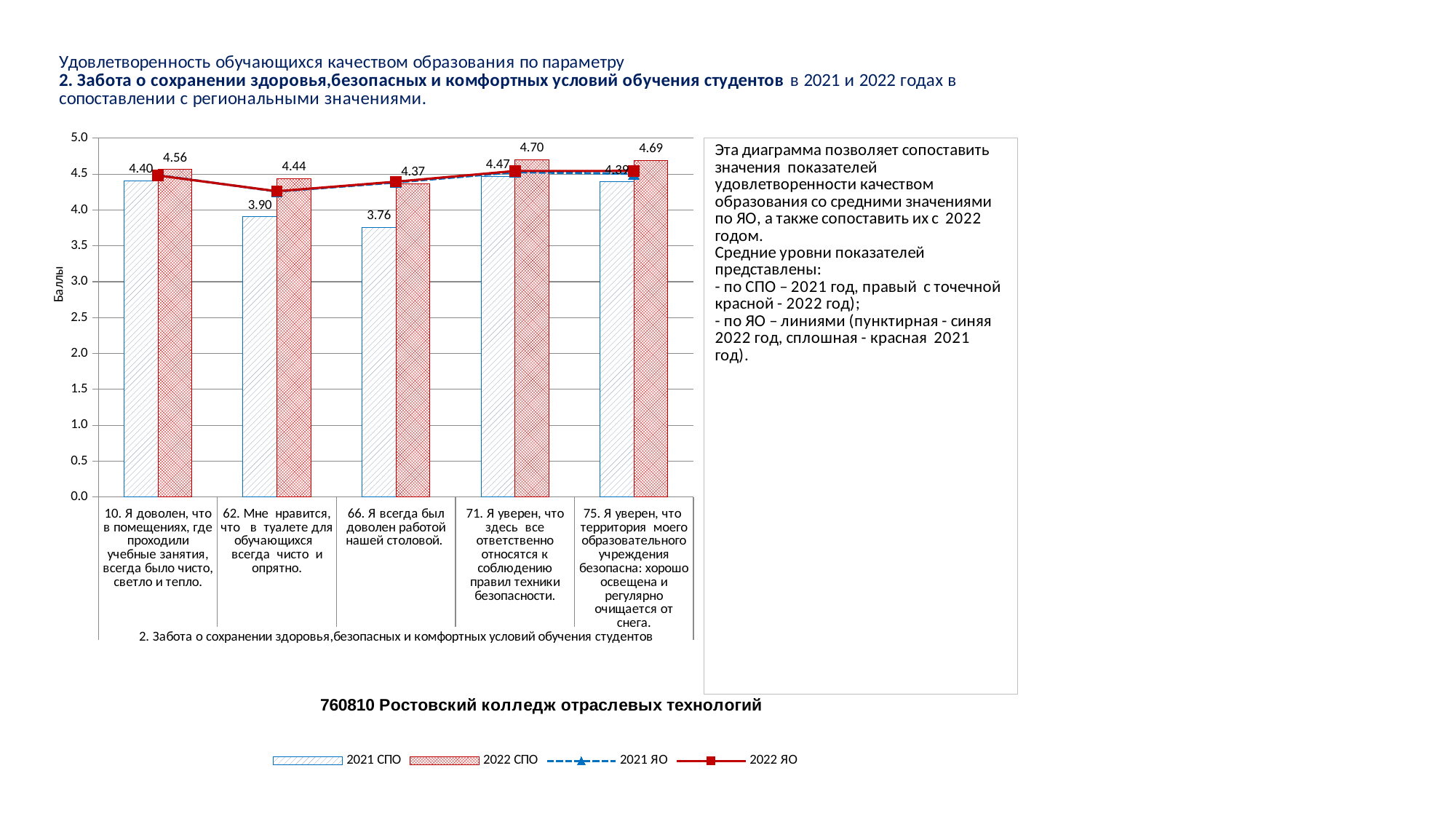
How many survey items (categories) are shown on the x axis? 5 What is the 2022 СПО value for item 62 (Мне нравится, что в туалете для обучающихся всегда чисто и опрятно)? 4.44 What is the difference between the 2022 СПО and 2021 СПО values for item 10? 0.16 What is the 2022 СПО value for item 10 (Я доволен, что в помещениях, где проходили учебные занятия, всегда было чисто, светло и тепло)? 4.56 How many series does the legend list? 4 Which item has the lowest 2022 СПО value? 66. Я всегда был доволен работой нашей столовой. For item 71, which is larger: the 2021 СПО value or the 2022 СПО value? 2022 СПО What is the 2021 СПО value for item 66 (Я всегда был доволен работой нашей столовой)? 3.76 What is the label of the vertical axis? Баллы What is the difference between the 2022 СПО and 2021 СПО values for item 62? 0.54 Is the 2021 СПО value for item 75 greater or less than 4.0? greater Which item has the lowest 2021 СПО value? 66. Я всегда был доволен работой нашей столовой.